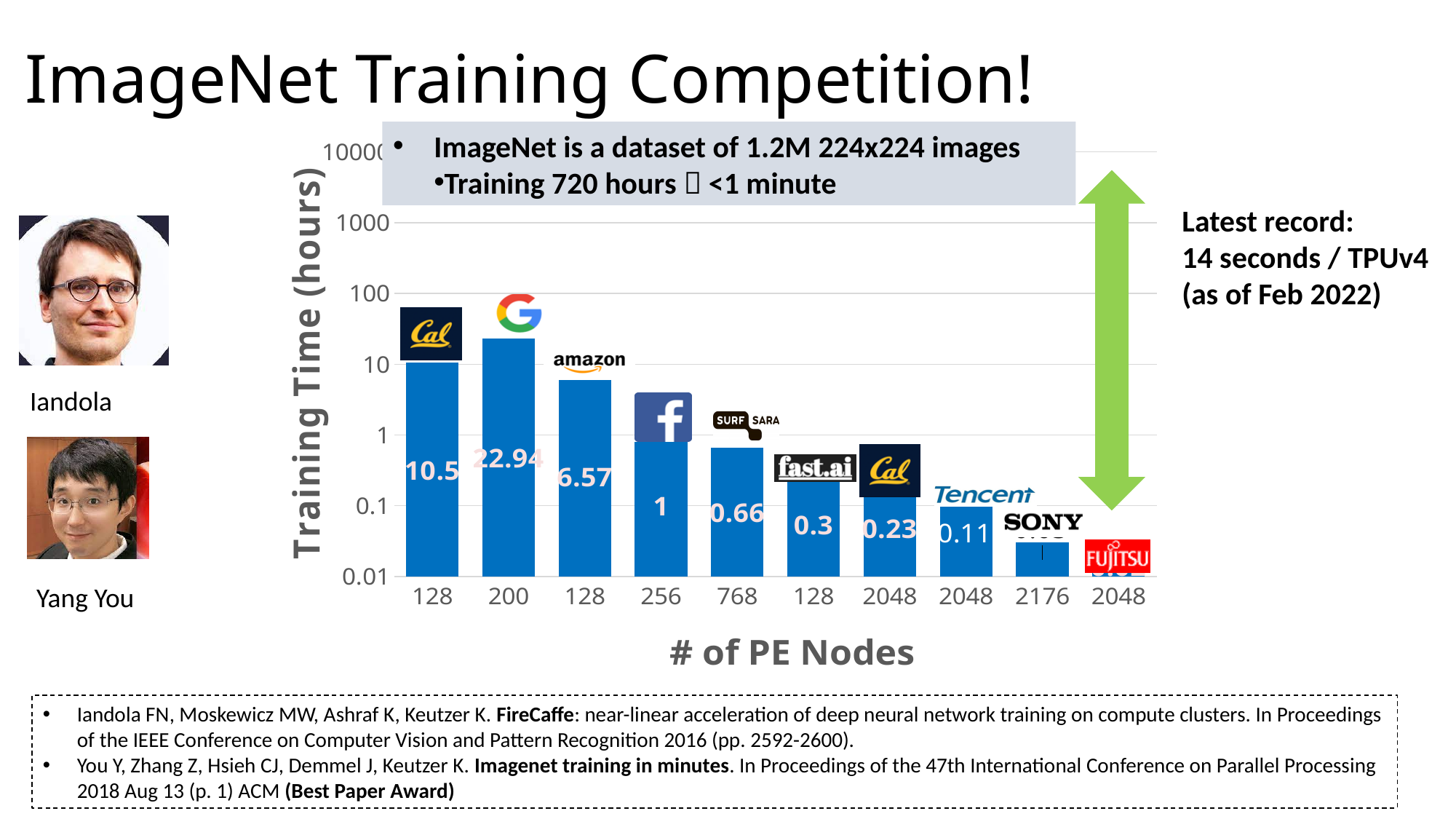
What is the training time for the bar with the Google logo? 22.94 What kind of chart is shown on the slide? bar chart What is the title of the vertical axis? Training Time (hours) What is the training time for the bar with the fast.ai logo? 0.3 What is the training time for the bar with the Amazon logo? 6.57 Which company's bar has the lowest training time? Fujitsu Which company's bar has the highest training time? Google Which has a larger training time, the Amazon bar or the Facebook bar? Amazon What is the training time for the bar with the Tencent logo? 0.11 Is the training time for the Sony bar greater or less than 0.1? less What is the difference in training time between the Google bar (22.94) and the first Cal bar (10.5)? 12.44 How many bars are plotted in the chart? 10